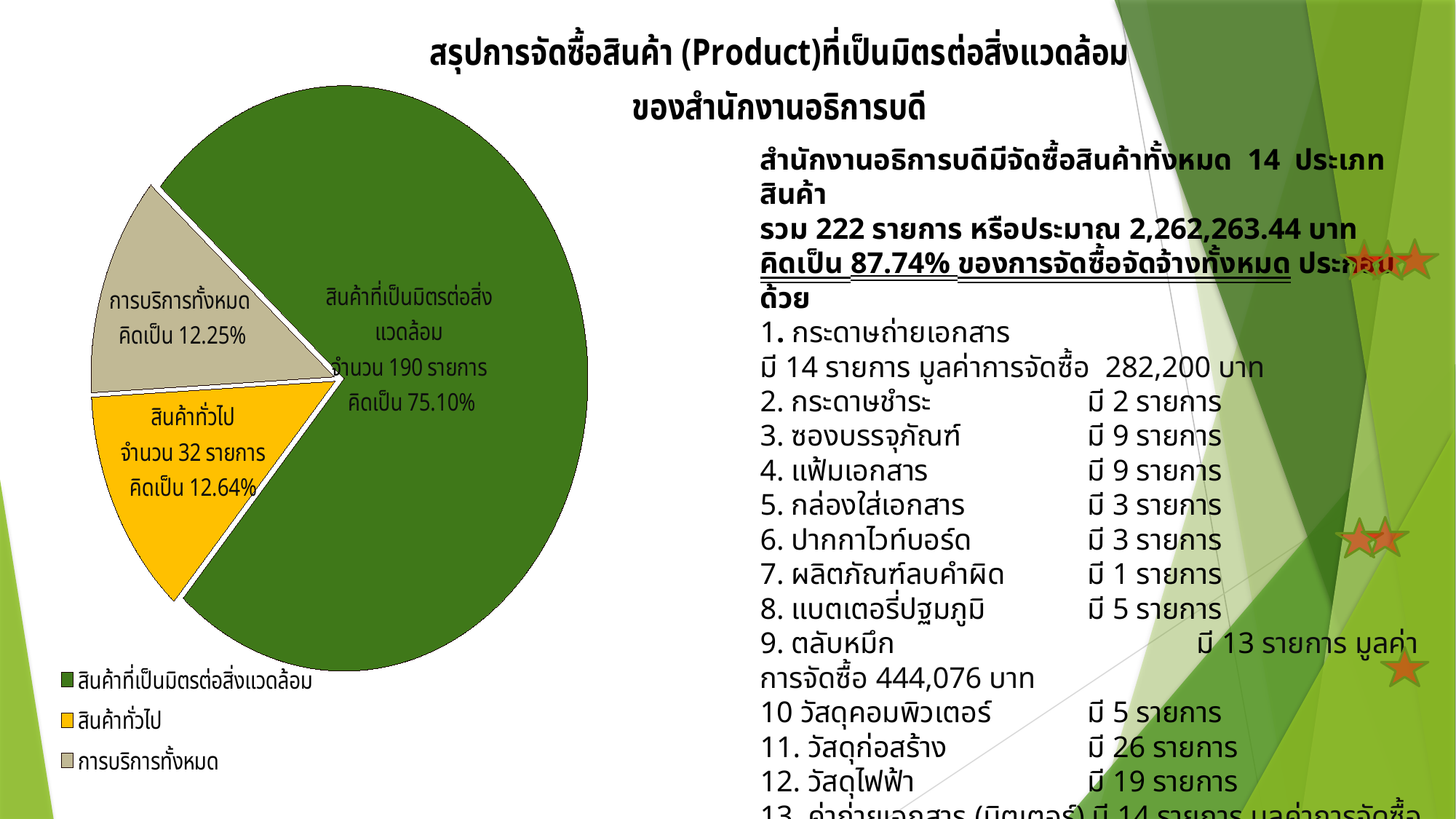
How many entries does the legend of the pie chart list? 3 What colour is the สินค้าทั่วไป slice in the pie chart? yellow How many รายการ are shown for สินค้าทั่วไป in the pie chart? 32 รายการ Which slice of the pie chart is the largest? สินค้าที่เป็นมิตรต่อสิ่งแวดล้อม What share of the pie does สินค้าทั่วไป represent? 12.64% How many slices does the pie chart have? 3 Which slice of the pie chart is the smallest? การบริการทั้งหมด What share of the pie does การบริการทั้งหมด represent? 12.25% What kind of chart is shown on the slide? pie chart What share of the pie does สินค้าที่เป็นมิตรต่อสิ่งแวดล้อม represent? 75.10% What is the difference in percentage between สินค้าทั่วไป and การบริการทั้งหมด in the pie chart? 0.39% How many รายการ are shown for สินค้าที่เป็นมิตรต่อสิ่งแวดล้อม in the pie chart? 190 รายการ